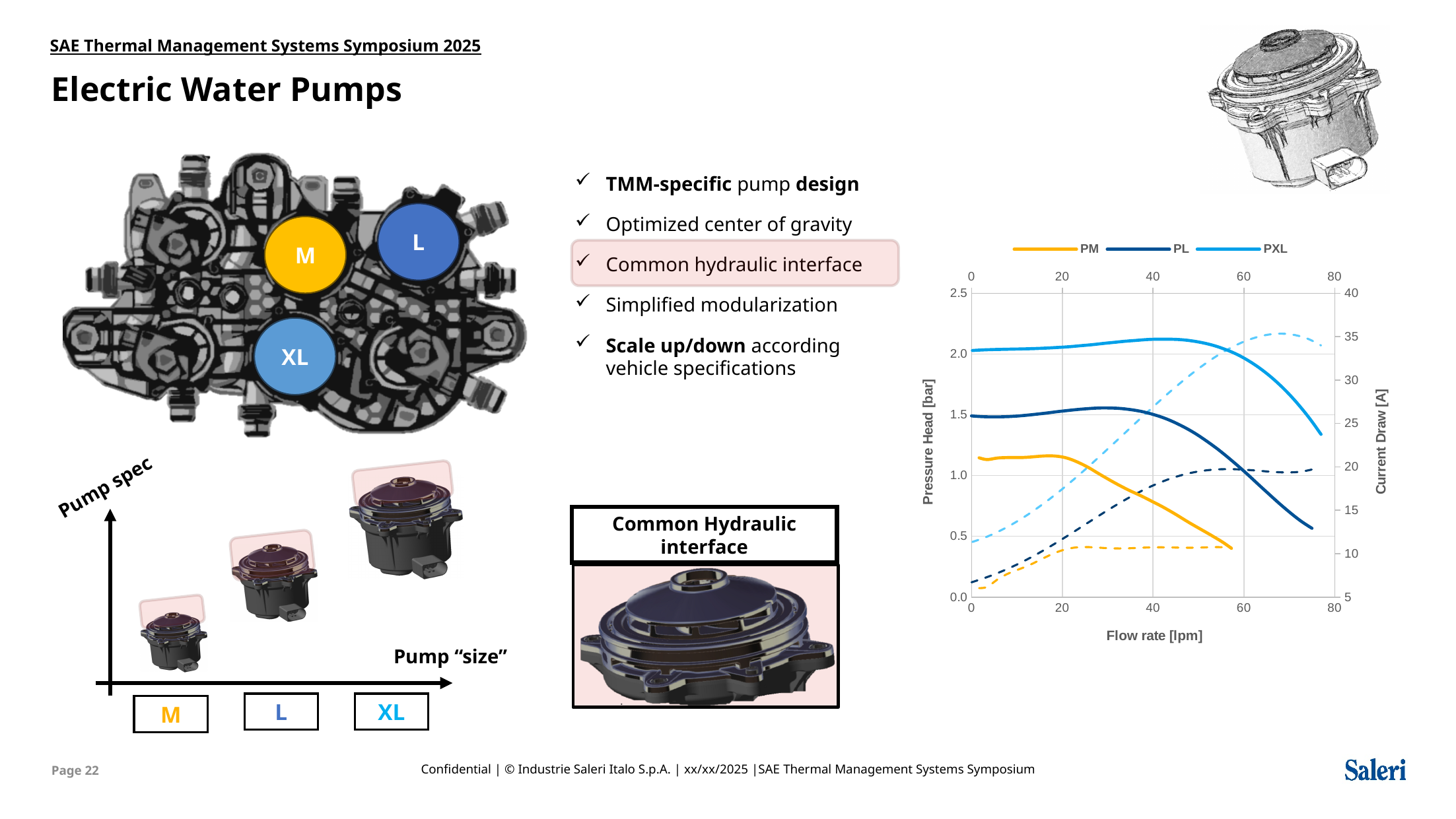
What is the label of the x axis of the chart? Flow rate [lpm] What kind of chart is shown on the right of the slide? line chart How many series does the legend of the chart list? 3 Does the solid PL pressure head line rise or fall as flow rate increases from 40 to 80 lpm? fall Which series has the highest pressure head at a flow rate of 20 lpm? PXL At a flow rate of 40 lpm, which has the higher pressure head, PM or PXL? PXL What are the three series names in the chart legend? PM, PL, PXL Is the pressure head of PM at a flow rate of 0 lpm greater or less than 1.5 bar? less Does the solid PM pressure head line rise or fall as flow rate increases from 20 to 60 lpm? fall Is the pressure head of PXL at a flow rate of 0 lpm greater or less than 1.5 bar? greater Is the pressure head of PL at a flow rate of 20 lpm greater or less than 1.0 bar? greater Which series has the lowest pressure head at a flow rate of 20 lpm? PM